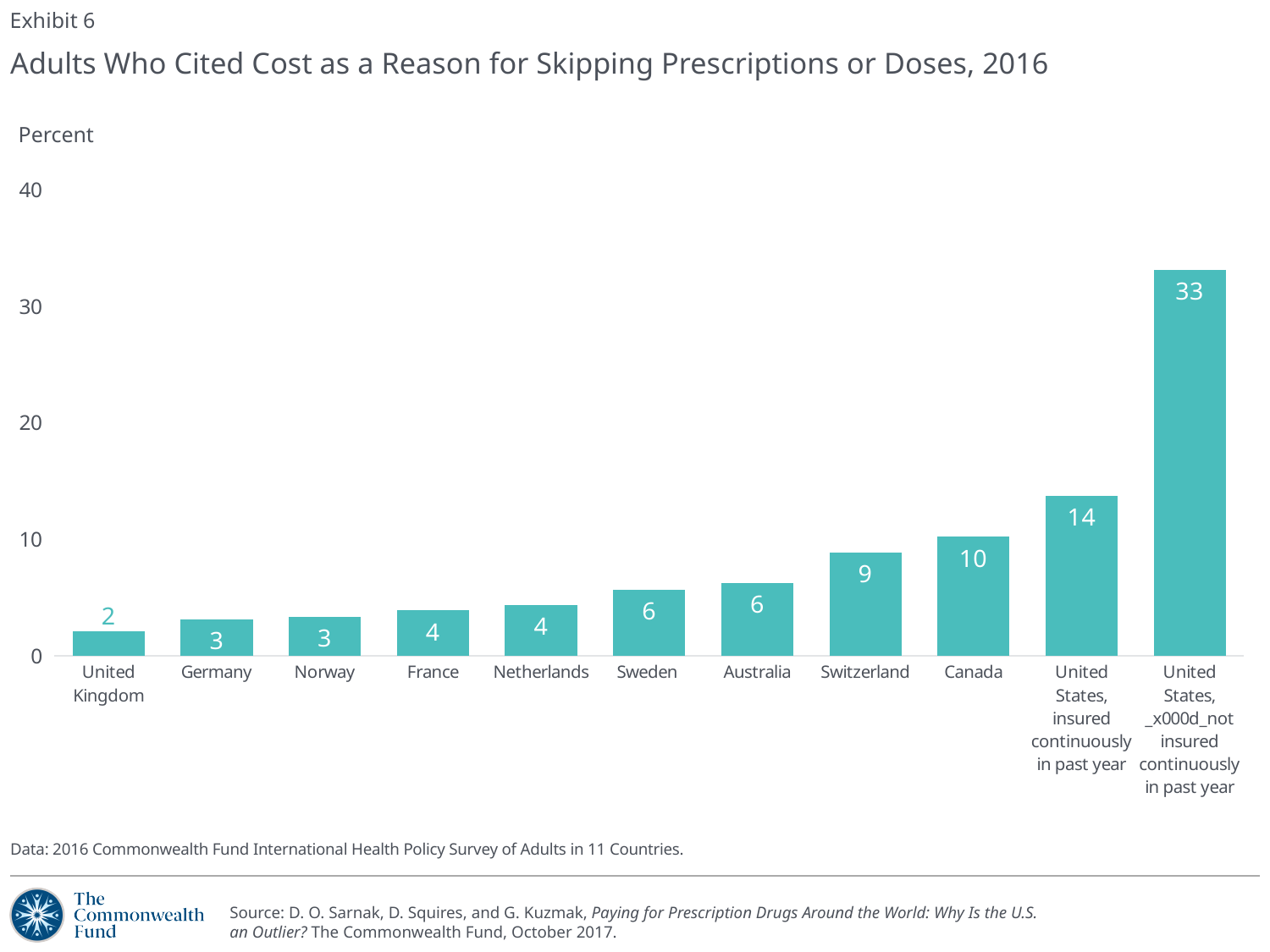
Which is larger, the value for Sweden or the value for Switzerland? Switzerland Is the value for United States, insured continuously in past year greater or less than 10? greater What is the value for Switzerland? 9 How many categories are shown on the x axis? 11 Which category has the lowest value? United Kingdom What kind of chart is this? Bar chart What is the value for the United Kingdom? 2 Which category has the highest value? United States, not insured continuously in past year What is the value for Canada? 10 What is the difference between the two United States categories (not insured continuously vs. insured continuously in past year)? 19 Do the values generally rise or fall from left to right along the x axis? Rise What unit is shown on the y axis label? Percent